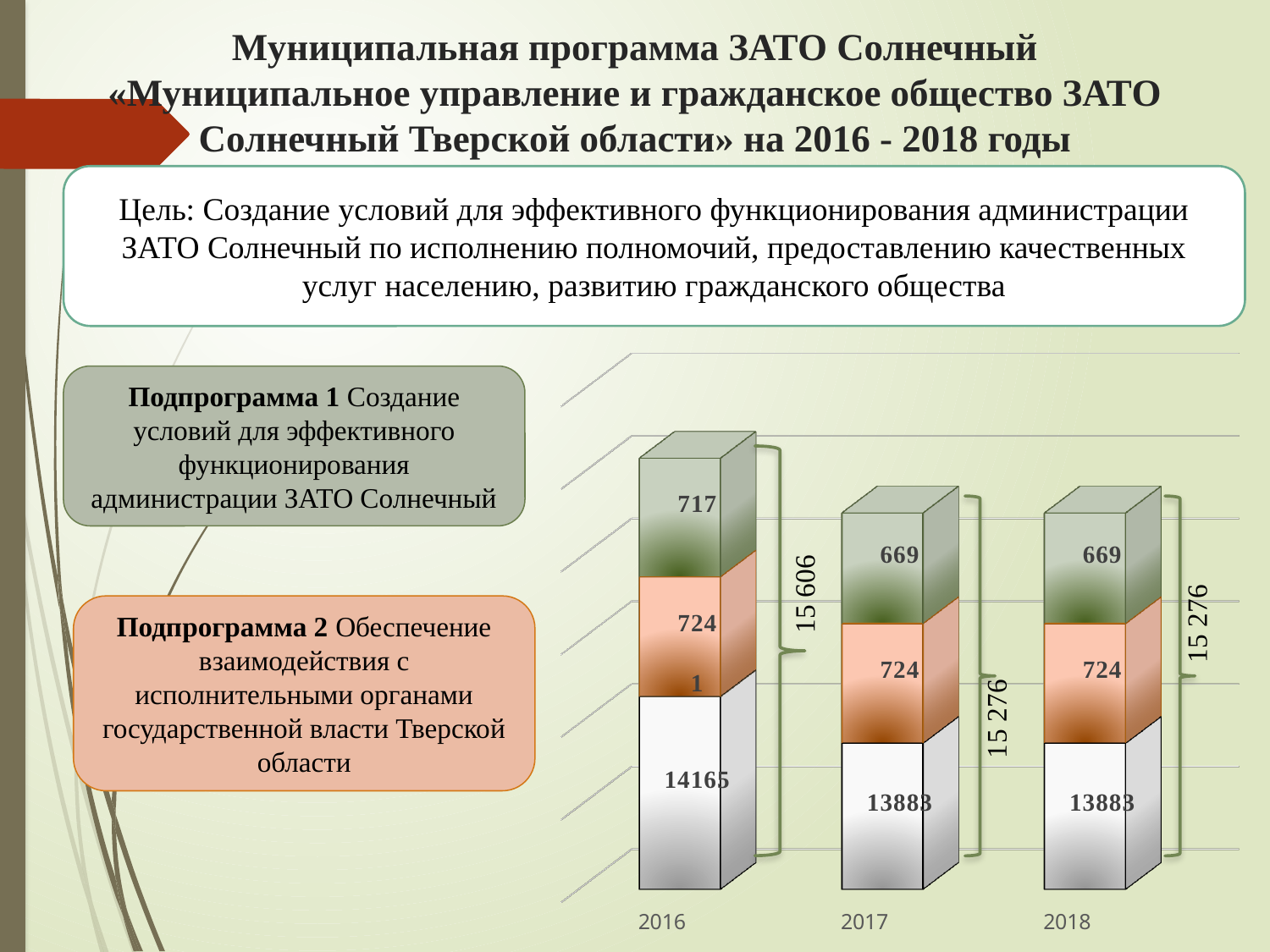
Is the top (green) segment larger in 2016 or in 2018? 2016 What is the value of the bottom (white) segment of the 2016 bar? 14165 What is the difference between the top (green) segment in 2016 and the top (green) segment in 2017? 48 What is the value of the orange segment of the 2017 bar? 724 What is the total shown for the 2018 bar? 15 276 What is the difference between the bottom (white) segment in 2016 and the bottom (white) segment in 2017? 282 What is the total shown for the 2016 bar? 15 606 Which year has the highest total? 2016 How many years (categories) are shown on the x axis of the chart? 3 What is the value of the bottom (white) segment of the 2018 bar? 13883 What type of chart is shown on the slide? stacked bar chart What is the value of the top (green) segment of the 2016 bar? 717